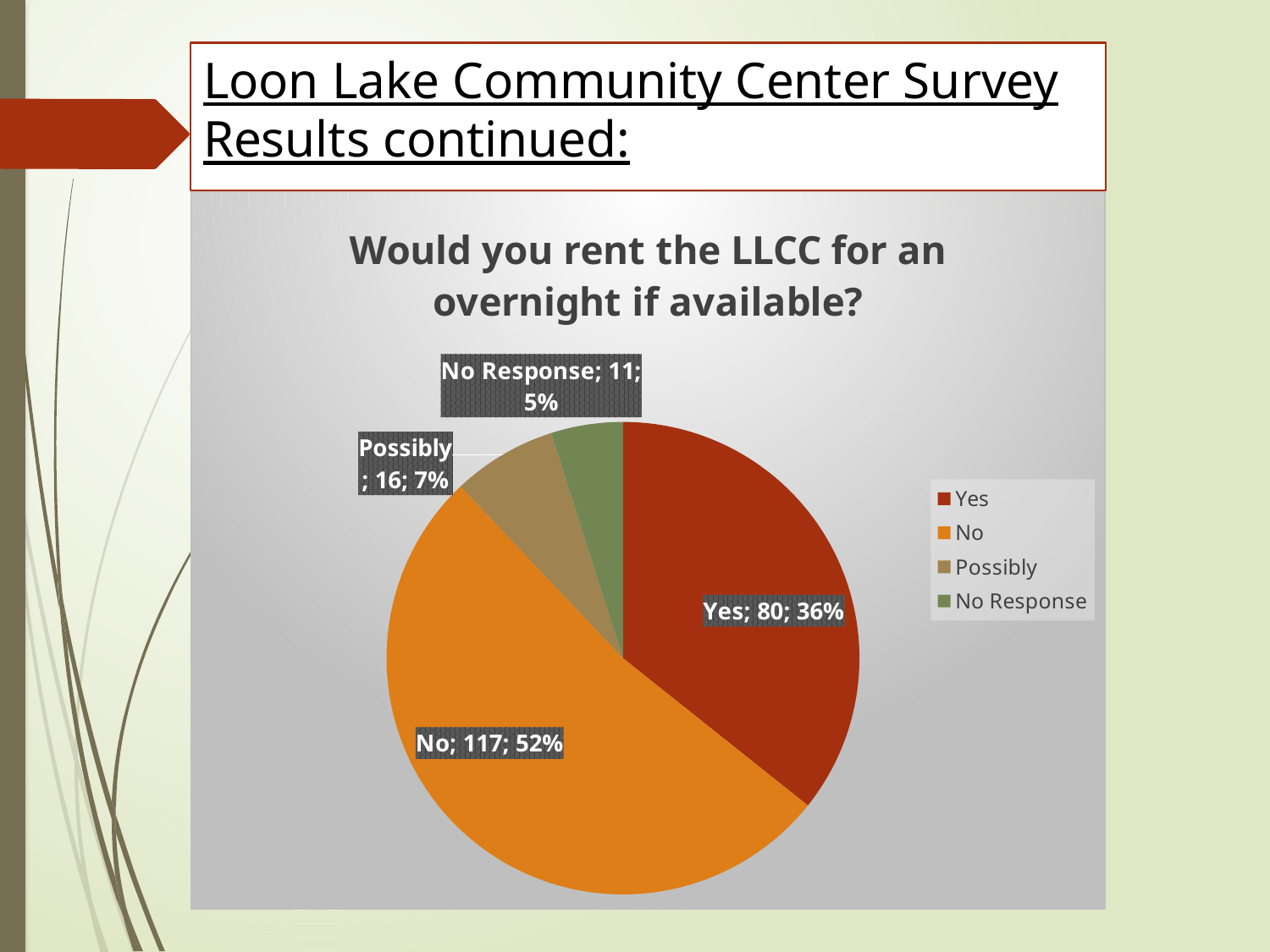
What is the title of the chart? Would you rent the LLCC for an overnight if available? What is the difference between the counts for "No" and "Yes"? 37 How many categories does the legend list? 4 Which response has the largest slice? No What percentage share does "No Response" have? 5% What is the count for "Possibly"? 16 What is the count for the "No" response? 117 What is the count for the "Yes" response? 80 What percentage share does "No" have? 52% What kind of chart is shown on the slide? pie chart Which response has the smallest slice? No Response How many slices does the pie chart have? 4